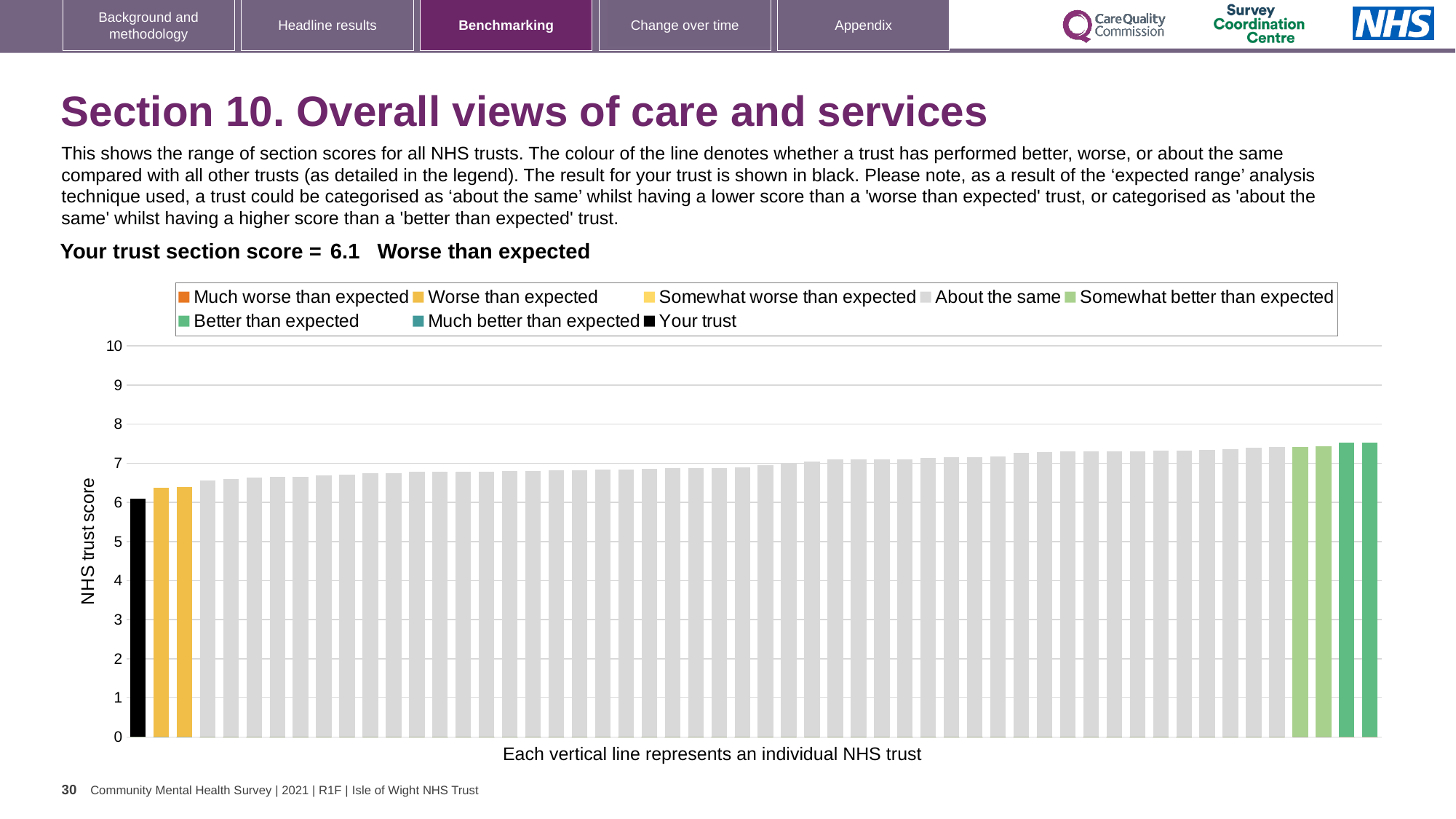
What kind of chart is shown on the slide? bar chart Is the value of the black 'Your trust' bar greater or less than 5? greater Is the tallest bar in the chart greater or less than 8? less What is the section score for your trust shown on the slide? 6.1 What colour is used for the 'Your trust' bar in the chart? black Is the tallest bar in the chart greater or less than 7? greater How many entries does the chart legend list? 8 Is the black 'Your trust' bar taller or shorter than the yellow 'Worse than expected' bars next to it? shorter How many bars are shaded green (somewhat better or better than expected) in the chart? 4 Do the bar values rise or fall from left to right across the chart? rise What is the label on the vertical axis of the chart? NHS trust score